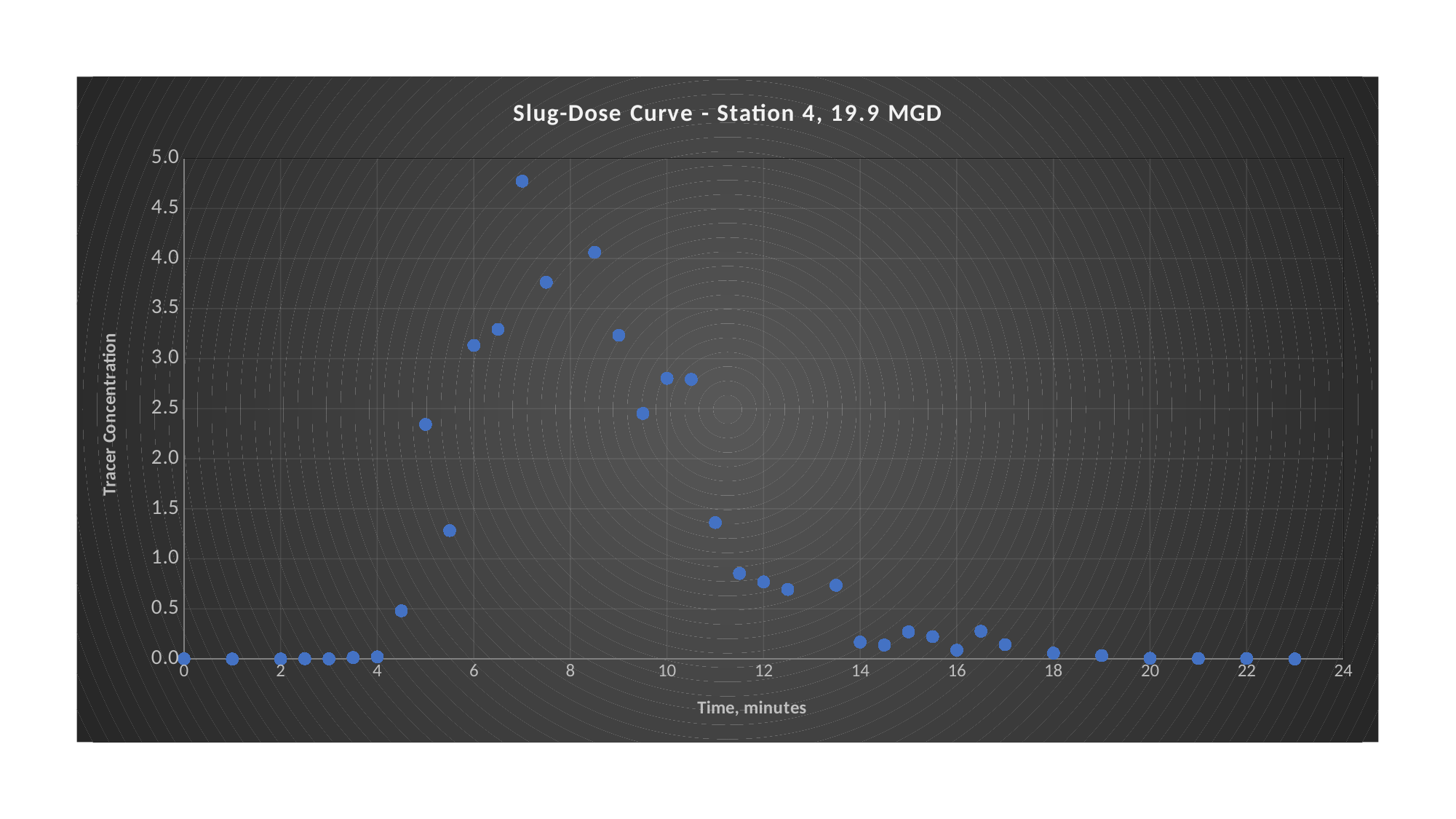
Is the tracer concentration at 12.5 minutes greater or less than 1.0? less Is the tracer concentration at 10 minutes greater or less than 3.0? less Is the tracer concentration at 11 minutes greater or less than 1.0? greater What is the tracer concentration at time 0 minutes? 0.0 What kind of chart is shown on the slide? Scatter chart What is the title of the chart? Slug-Dose Curve - Station 4, 19.9 MGD Which has the higher tracer concentration: 7 minutes or 8.5 minutes? 7 minutes What is the label of the horizontal axis? Time, minutes Between 4 and 7 minutes, does the tracer concentration rise or fall? rise